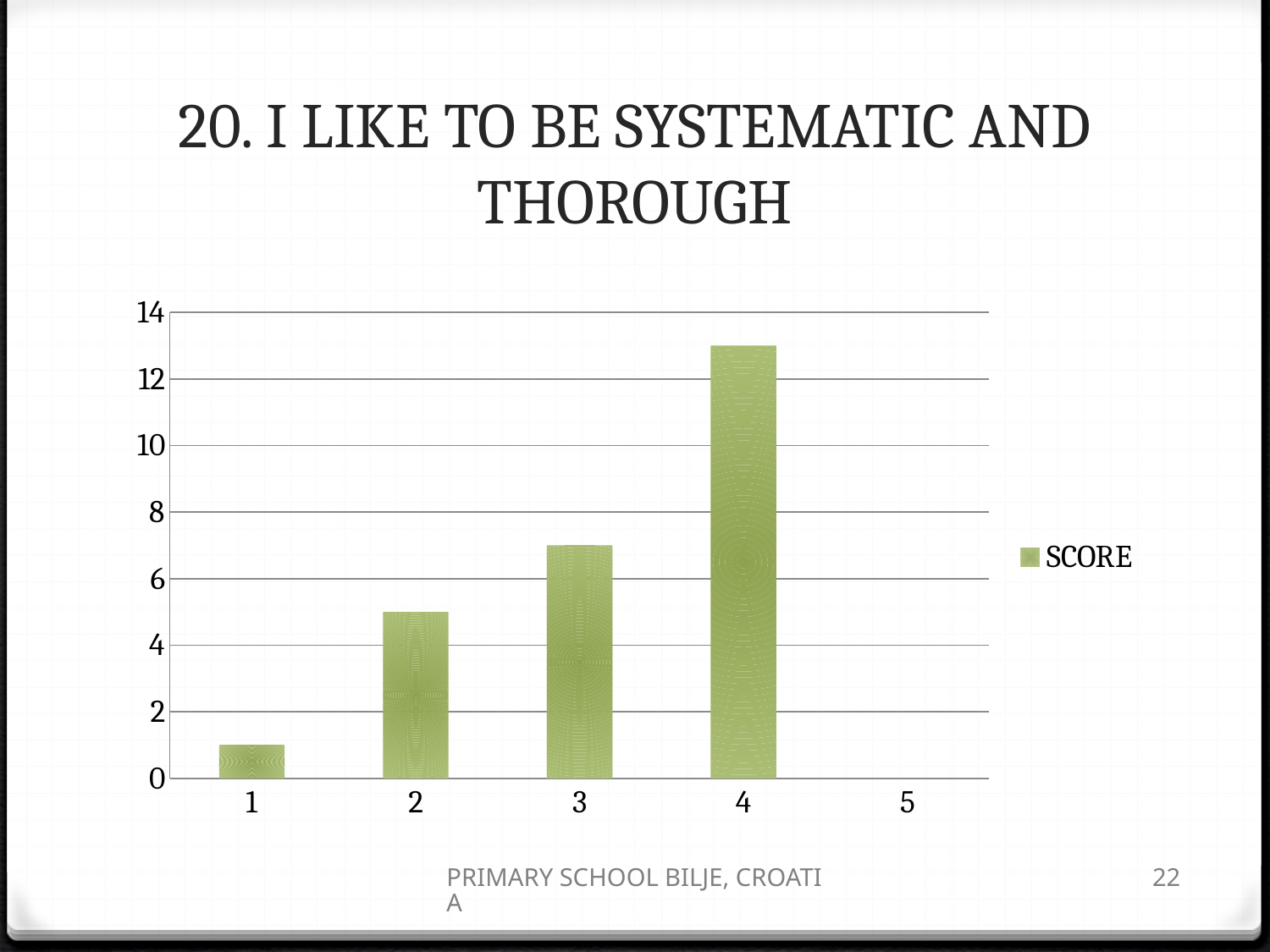
Which is larger, the value for category 3 or the value for category 4? 4 How many categories are shown on the x axis? 5 Which is larger, the value for category 1 or the value for category 2? 2 What kind of chart is shown on the slide? bar chart What is the name of the series shown in the legend? SCORE Is the value for category 1 greater or less than 2? less Is the value for category 4 greater or less than 12? greater How many series does the legend list? 1 Is the value for category 3 greater or less than 8? less Which category has the shortest visible bar? 1 Which category has the highest bar? 4